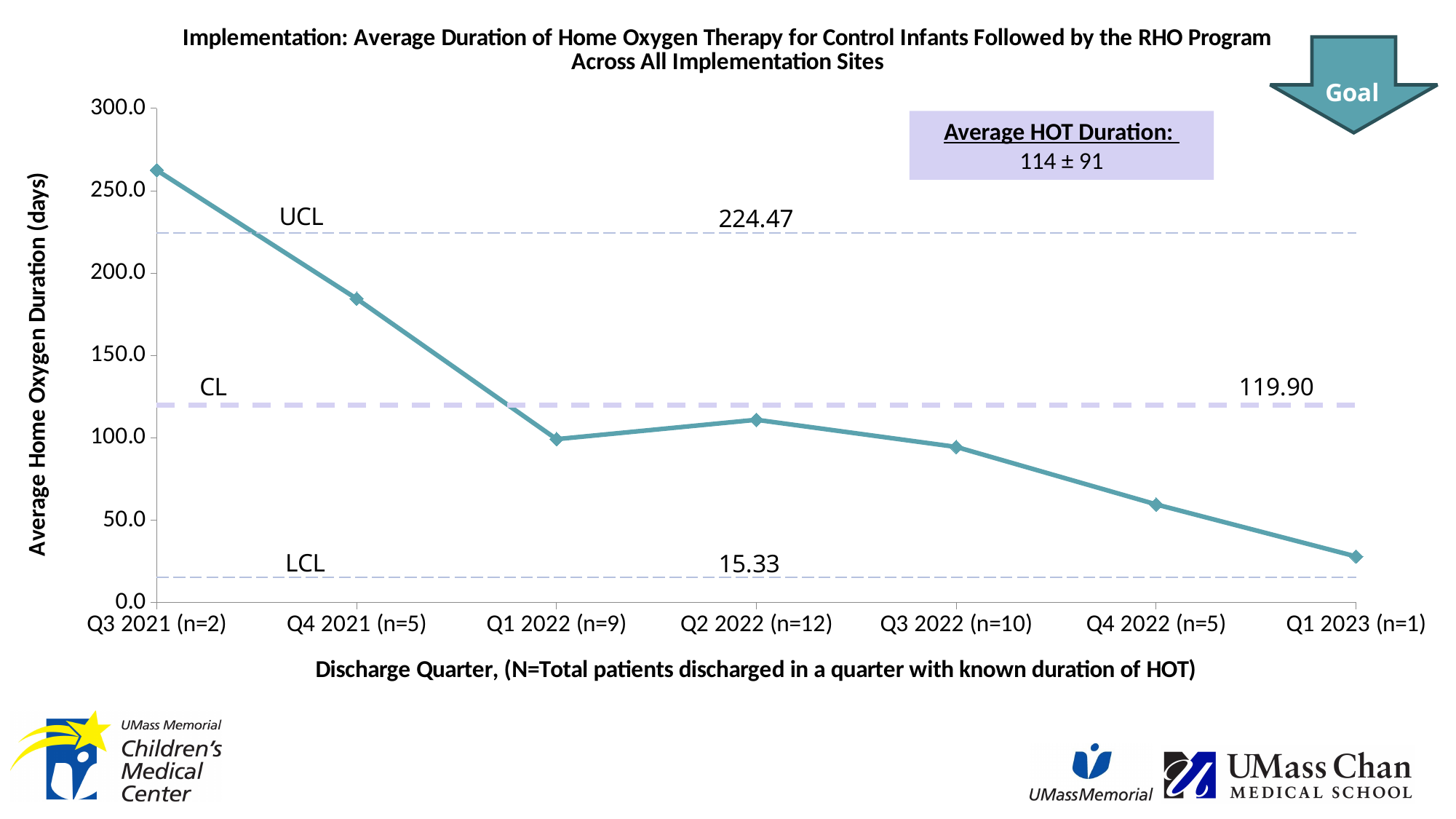
What is the Average HOT Duration stated in the box on the chart? 114 ± 91 What is the value of the CL line? 119.90 Which is larger, the value for Q4 2021 (n=5) or the value for Q2 2022 (n=12)? Q4 2021 (n=5) Is the value for Q3 2021 (n=2) greater or less than 250? greater Which discharge quarter has the highest average home oxygen duration? Q3 2021 (n=2) What is the value of the UCL line? 224.47 Is the value for Q4 2022 (n=5) greater or less than 100? less Which discharge quarter has the lowest average home oxygen duration? Q1 2023 (n=1) How many discharge quarters are plotted on the x axis? 7 What is the difference between the UCL and the LCL values? 209.14 What kind of chart is shown on the slide? line chart What is the value of the LCL line? 15.33